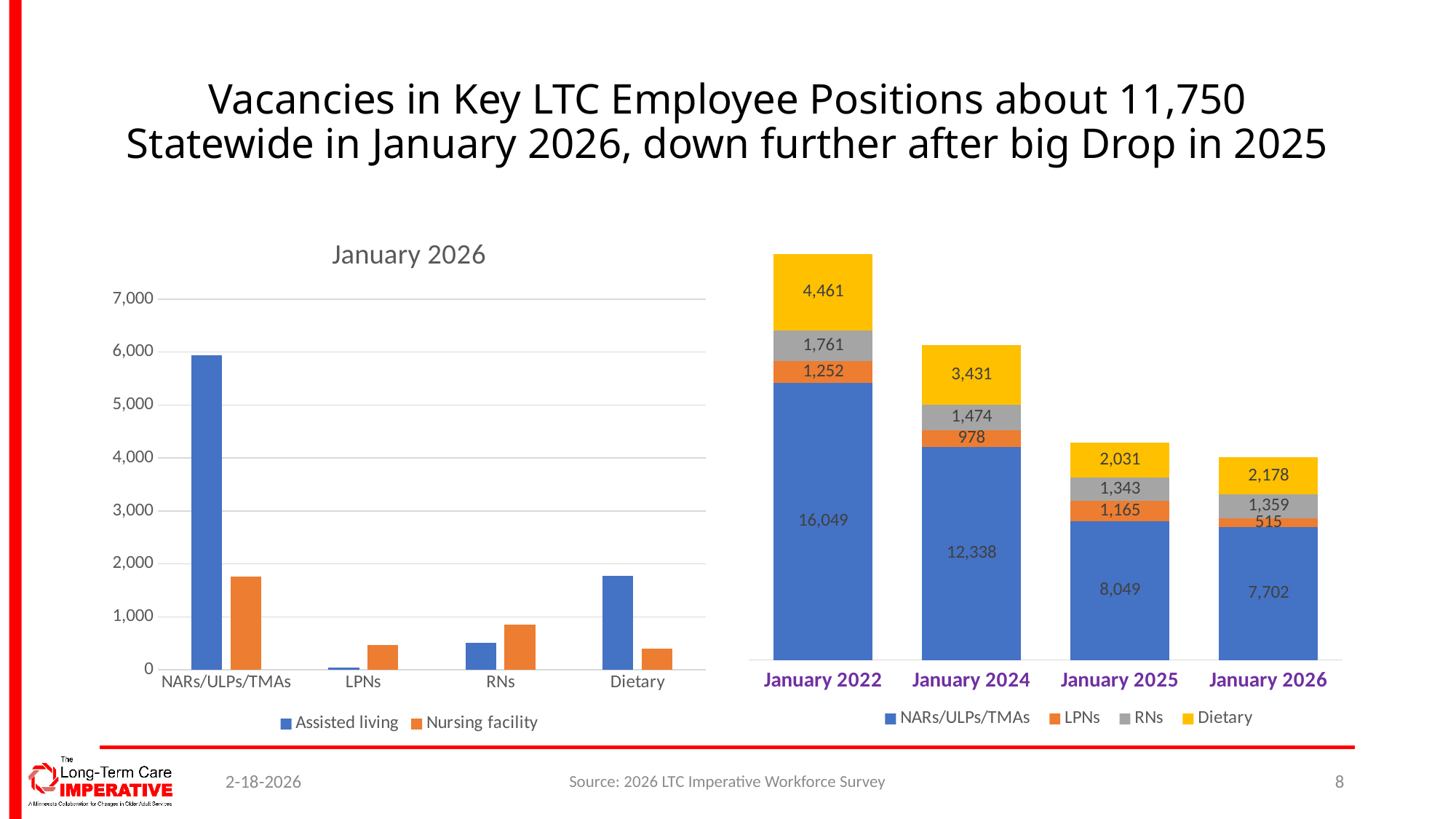
In the January 2026 chart on the left, is the Assisted living value for NARs/ULPs/TMAs greater or less than 5,000? greater In the stacked bar chart on the right, do the NARs/ULPs/TMAs values rise or fall from January 2022 to January 2026? fall In the stacked bar chart on the right, what is the NARs/ULPs/TMAs value for January 2022? 16,049 In the stacked bar chart on the right, what is the Dietary value for January 2025? 2,031 In the January 2026 chart on the left, how many series does the legend list? 2 In the stacked bar chart on the right, what is the difference between the LPNs values for January 2025 and January 2026? 650 In the January 2026 chart on the left, what kind of chart is shown? bar chart In the stacked bar chart on the right, what is the total of the January 2026 bar? 11,754 In the January 2026 chart on the left, is the Nursing facility value for RNs greater or less than 1,000? less In the January 2026 chart on the left, for Dietary, which is larger: Assisted living or Nursing facility? Assisted living In the January 2026 chart on the left, which category has the lowest Assisted living value? LPNs In the January 2026 chart on the left, which category has the highest Assisted living value? NARs/ULPs/TMAs